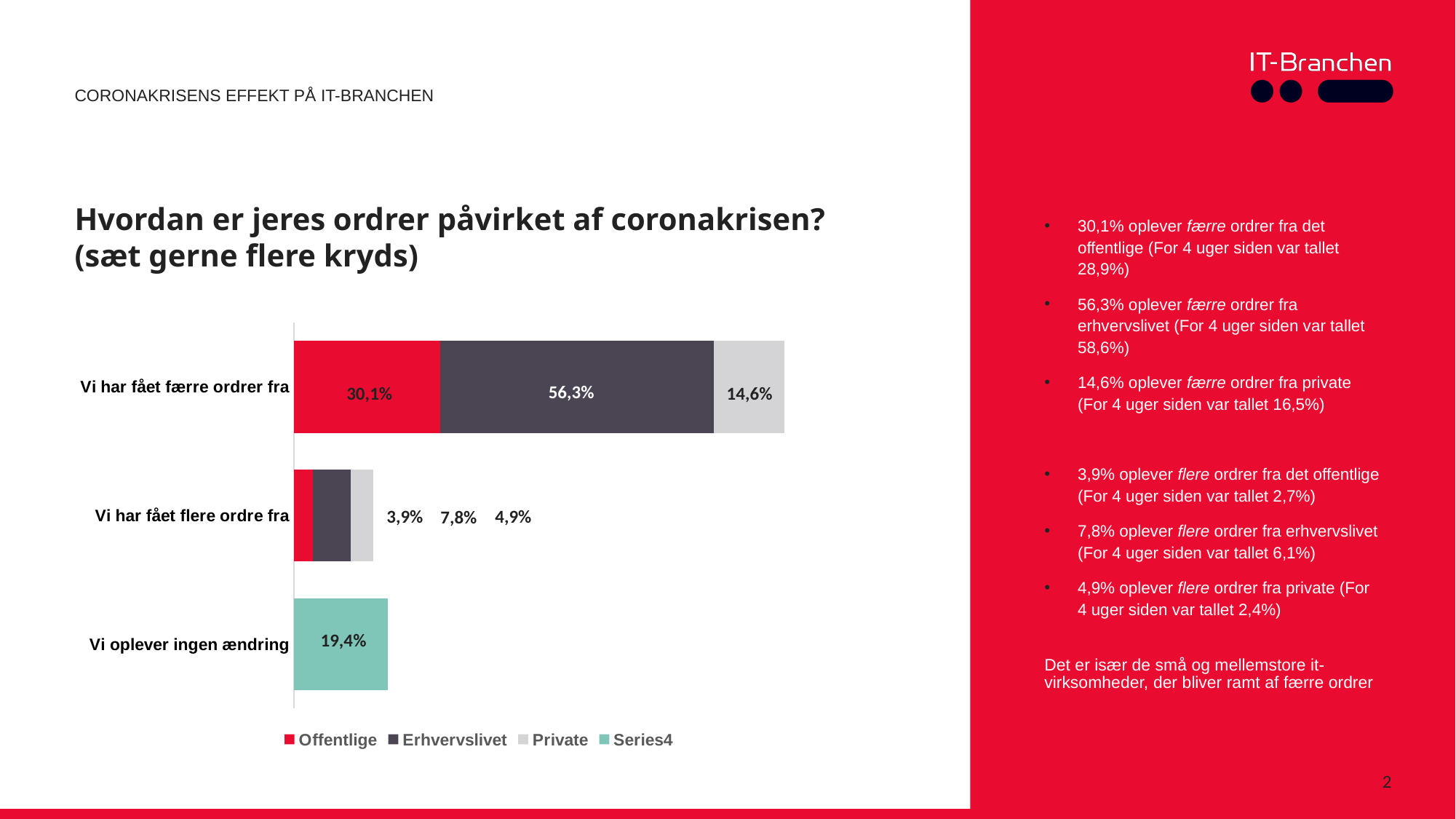
Which series has the highest value in the 'Vi har fået færre ordrer fra' bar? Erhvervslivet What is the value for Offentlige in the 'Vi har fået færre ordrer fra' bar? 30,1% What is the value for Private in the 'Vi har fået flere ordre fra' bar? 4,9% What is the value shown for 'Vi oplever ingen ændring'? 19,4% How many series does the legend list? 4 What is the total of the 'Vi har fået flere ordre fra' stacked bar? 16,6% Which is larger: the Private value for 'Vi har fået færre ordrer fra' or the Private value for 'Vi har fået flere ordre fra'? Vi har fået færre ordrer fra How many categories are shown on the chart? 3 What kind of chart is shown on the slide? Stacked bar chart What is the value for Erhvervslivet in the 'Vi har fået færre ordrer fra' bar? 56,3% What is the difference between the Erhvervslivet and Offentlige values in the 'Vi har fået færre ordrer fra' bar? 26,2% Which series has the lowest value in the 'Vi har fået flere ordre fra' bar? Offentlige